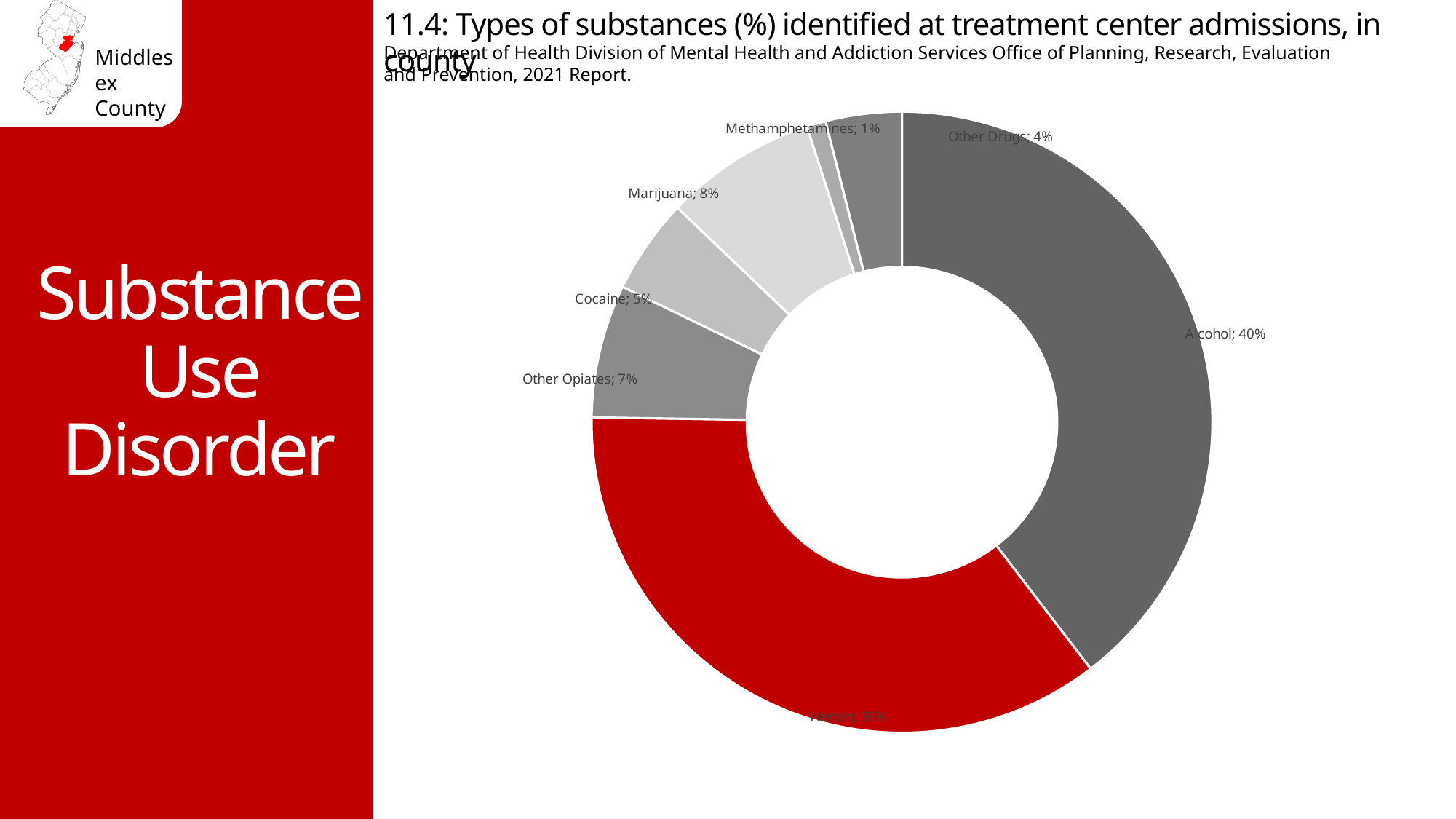
What kind of chart is shown on the slide? doughnut chart Which has a larger share, Alcohol or Heroin? Alcohol Which has a larger share, Marijuana or Cocaine? Marijuana What percentage is shown for Other Drugs? 4% What percentage is shown for Marijuana? 8% What percentage of treatment center admissions is attributed to Alcohol? 40% What percentage is shown for Methamphetamines? 1% What percentage is shown for Cocaine? 5% What colour is the Heroin slice of the chart? red What percentage is shown for Other Opiates? 7% Which substance has the largest share of admissions? Alcohol What is the difference in percentage points between Alcohol and Other Opiates? 33%